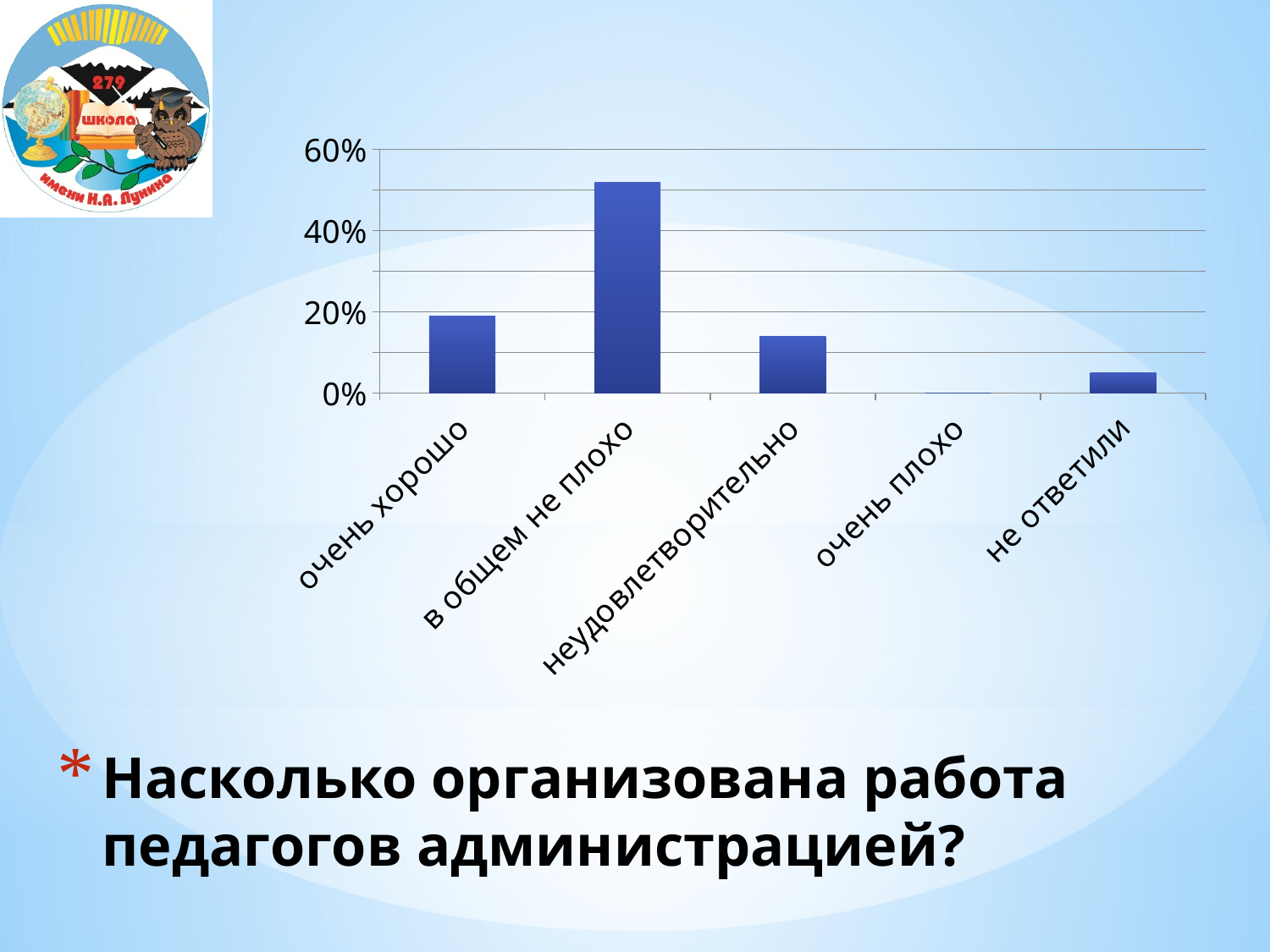
What kind of chart is shown on the slide? bar chart Which is larger, the value for "не ответили" or the value for "неудовлетворительно"? неудовлетворительно Is the value for "не ответили" greater or less than 20%? less Is the value for "в общем не плохо" greater or less than 40%? greater How many categories are shown on the x axis of the chart? 5 What question does the text below the chart pose? Насколько организована работа педагогов администрацией? Which category has the lowest bar? очень плохо Which is larger, the value for "очень хорошо" or the value for "неудовлетворительно"? очень хорошо Which category has the highest bar? в общем не плохо Is the value for "в общем не плохо" greater or less than 60%? less What is the highest value shown on the vertical axis of the chart? 60%